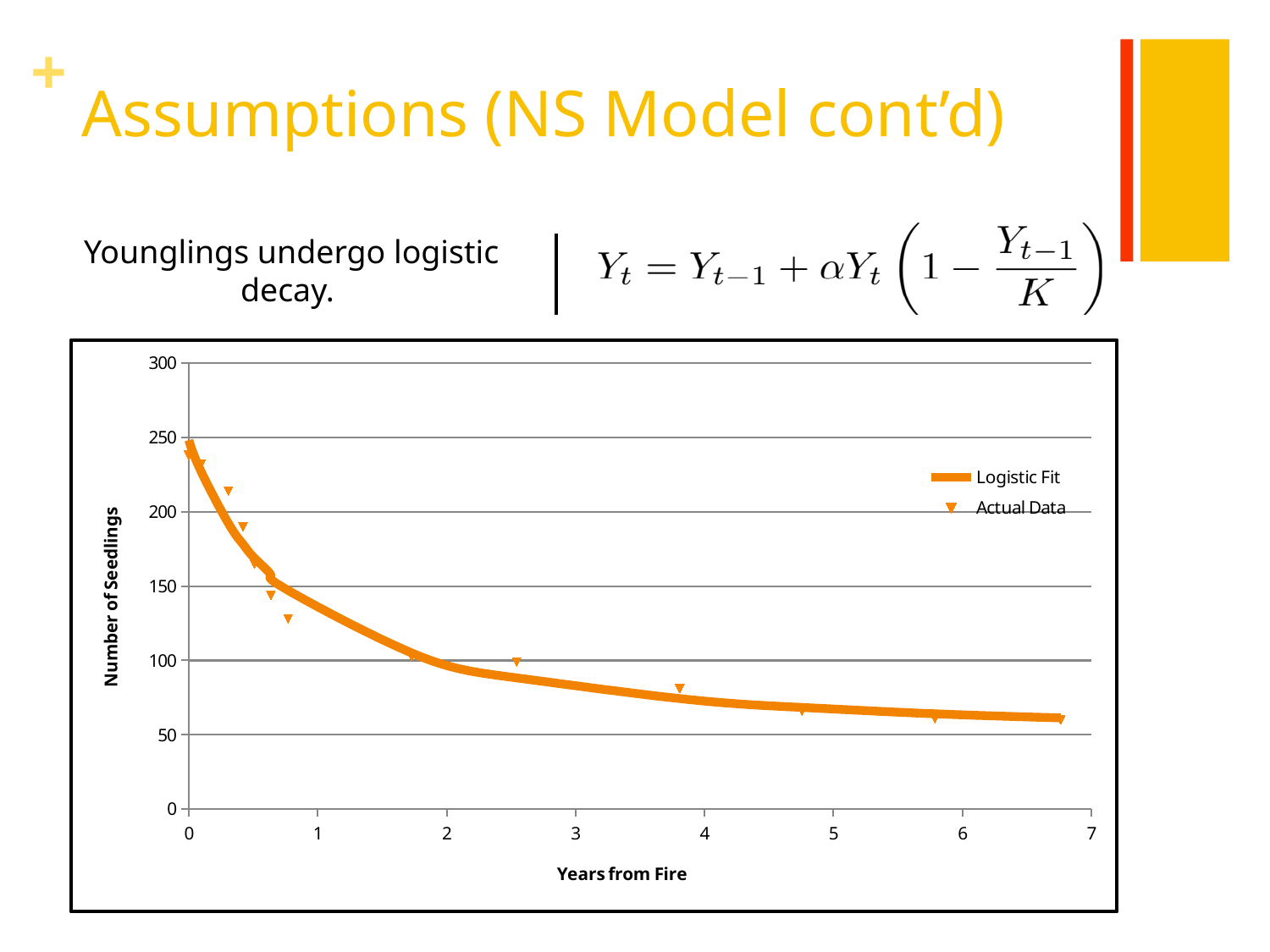
Is the value of the Logistic Fit at 6 years from fire greater or less than 50? greater What are the two series named in the legend? Logistic Fit and Actual Data At roughly which Years from Fire value does the highest Actual Data point occur? 0 Is the Actual Data point near 3.8 years from fire greater or less than 100? less Is the Actual Data point near 5.8 years from fire greater or less than 50? greater How many series does the legend list? 2 What is the label of the vertical axis? Number of Seedlings What kind of chart is shown on the slide? line chart Do the values of the Logistic Fit rise or fall as Years from Fire increases? fall Which Actual Data point is larger: the one near 0.8 years from fire or the one near 3.8 years from fire? the one near 0.8 years